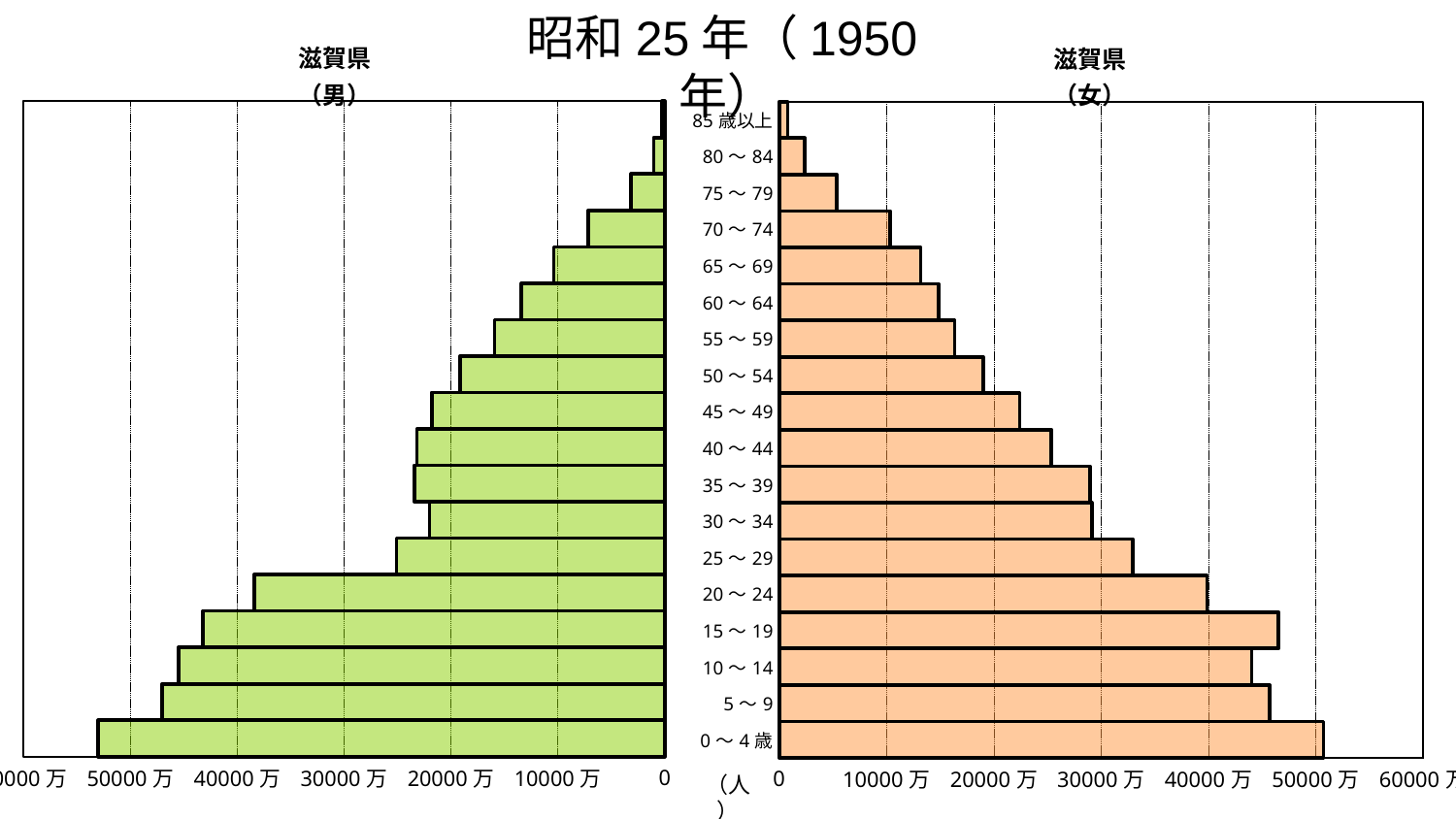
In the 滋賀県（女） chart on the right, is the value for 15～19 greater or less than 50000万? less In the 滋賀県（女） chart on the right, which age group has the largest value? 0～4歳 In the 滋賀県（男） chart on the left, which is larger, the value for 20～24 or the value for 25～29? 20～24 In the 滋賀県（男） chart on the left, is the value for 70～74 greater or less than 10000万? less How many age groups are plotted in the 滋賀県（男） chart? 18 In the 滋賀県（男） chart on the left, which age group has the largest value? 0～4歳 In the 滋賀県（男） chart on the left, is the value for 0～4歳 greater or less than 50000万? greater What colour are the bars in the 滋賀県（女） chart on the right? orange In the 滋賀県（女） chart on the right, which age group has the smallest value? 85歳以上 In the 滋賀県（女） chart on the right, do the values generally rise or fall as the age groups get older? fall What kind of chart is shown on the slide? bar chart